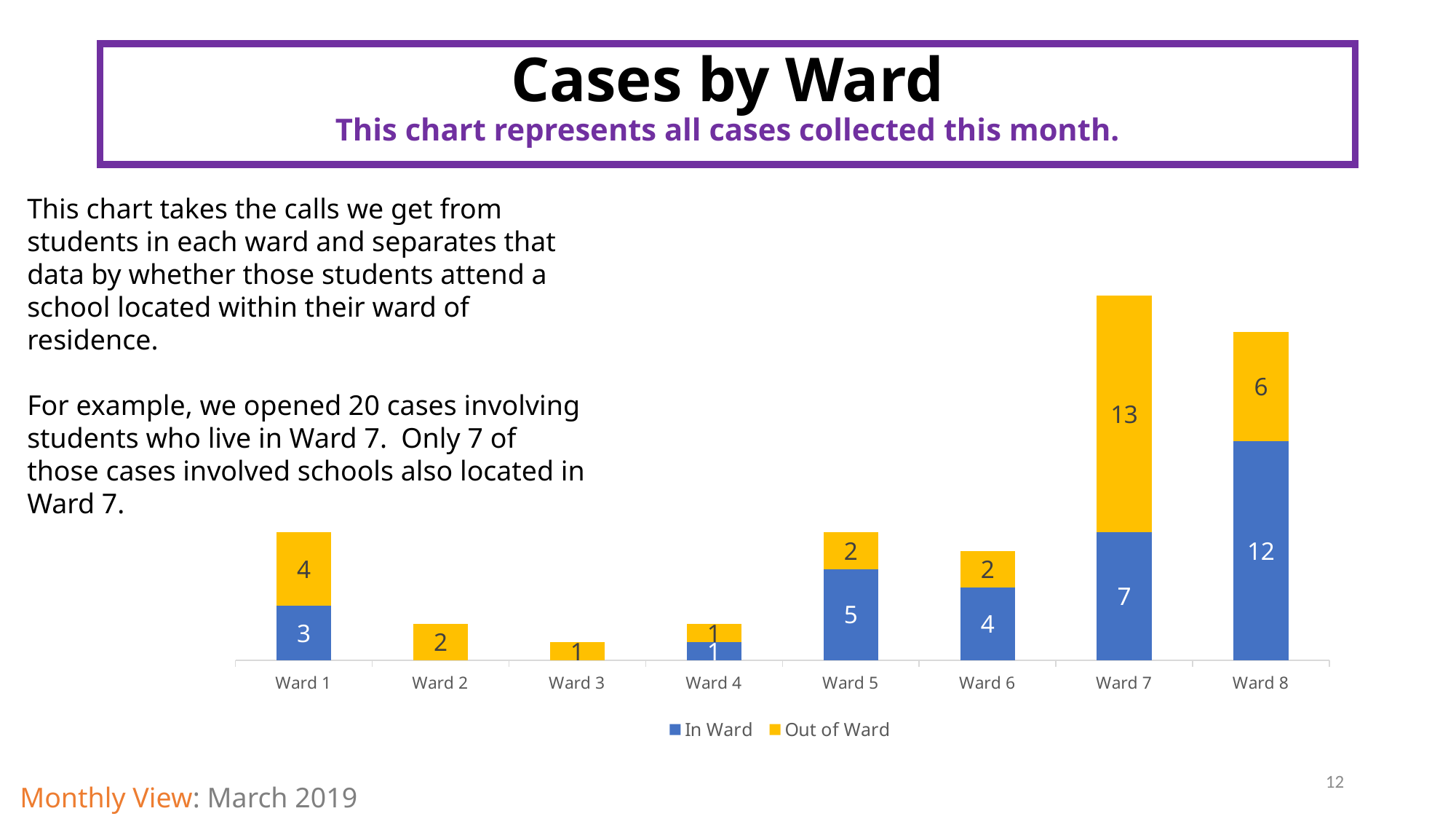
What type of chart is shown on the slide? Stacked bar chart Which ward has the highest In Ward value? Ward 8 How many wards are shown on the x axis? 8 What is the Out of Ward value for Ward 8? 6 What is the In Ward value for Ward 7? 7 What is the total number of cases for Ward 7 (In Ward plus Out of Ward)? 20 What is the total number of cases for Ward 8 (In Ward plus Out of Ward)? 18 How many series does the legend list? 2 What is the Out of Ward value for Ward 1? 4 Which ward has the highest Out of Ward value? Ward 7 What is the difference between the Out of Ward value for Ward 7 and the Out of Ward value for Ward 8? 7 Which is larger: the In Ward value for Ward 5 or the In Ward value for Ward 6? Ward 5